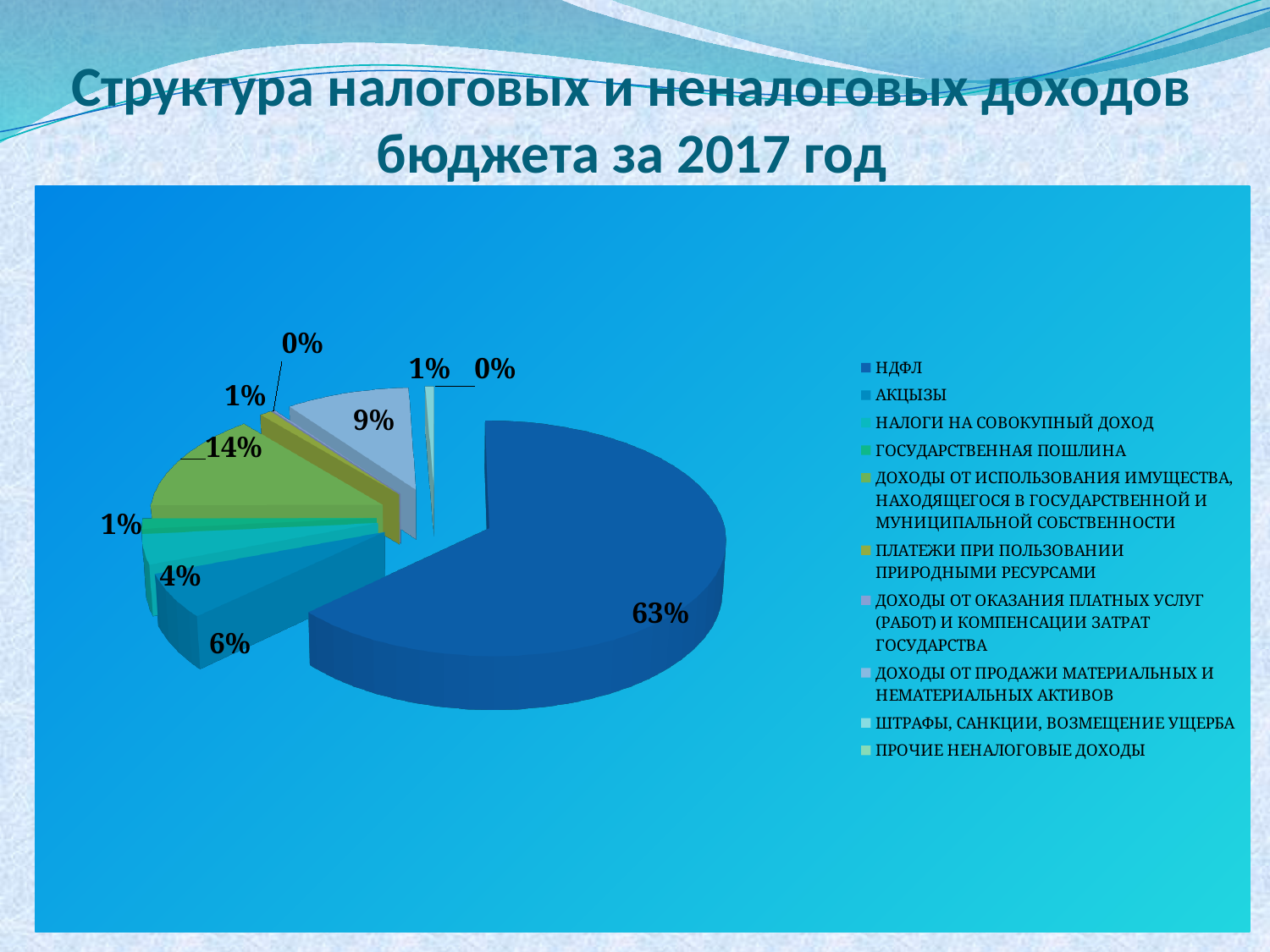
What is the difference between the share of НДФЛ and the share of ДОХОДЫ ОТ ИСПОЛЬЗОВАНИЯ ИМУЩЕСТВА, НАХОДЯЩЕГОСЯ В ГОСУДАРСТВЕННОЙ И МУНИЦИПАЛЬНОЙ СОБСТВЕННОСТИ? 49% Which category has the largest share of the pie? НДФЛ What share of the pie does НДФЛ have? 63% What share of the pie does НАЛОГИ НА СОВОКУПНЫЙ ДОХОД have? 4% What share of the pie does АКЦИЗЫ have? 6% What kind of chart is shown on the slide? Pie chart What is the first entry listed in the legend? НДФЛ How many entries does the legend list? 10 Which is larger, the share of АКЦИЗЫ or the share of ДОХОДЫ ОТ ПРОДАЖИ МАТЕРИАЛЬНЫХ И НЕМАТЕРИАЛЬНЫХ АКТИВОВ? ДОХОДЫ ОТ ПРОДАЖИ МАТЕРИАЛЬНЫХ И НЕМАТЕРИАЛЬНЫХ АКТИВОВ What is the title of the slide? Структура налоговых и неналоговых доходов бюджета за 2017 год